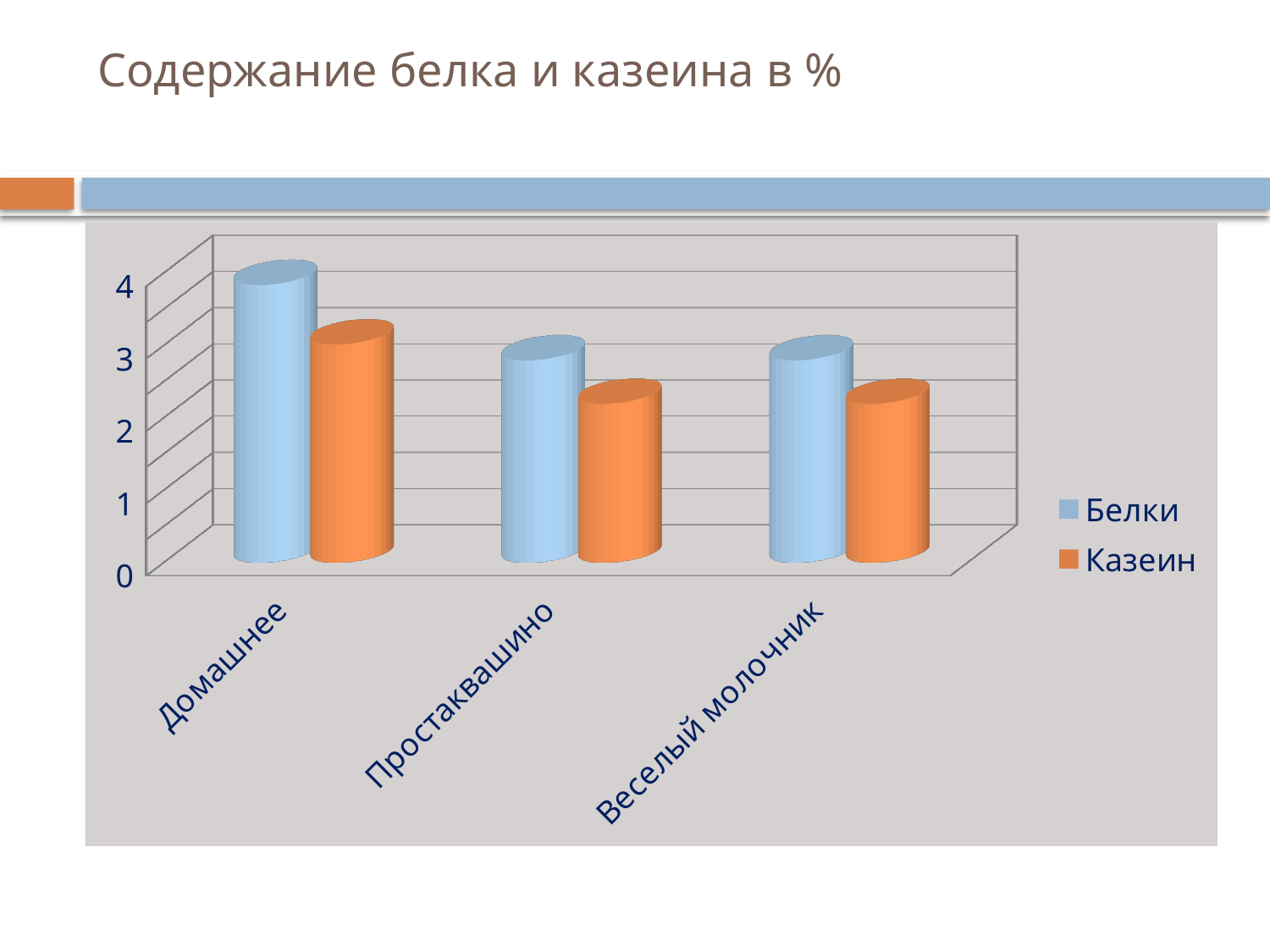
What is the title of the chart on the slide? Содержание белка и казеина в % Is the Казеин value for Простаквашино greater or less than 3? less For Домашнее, which is larger: Белки or Казеин? Белки Which is larger: the Белки value for Домашнее or the Белки value for Простаквашино? Домашнее How many series does the legend list? 2 Which category has the highest Казеин value? Домашнее Which category has the highest Белки value? Домашнее How many categories are shown on the x axis? 3 Is the Белки value for Домашнее greater or less than 3? greater What kind of chart is shown on the slide? bar chart Which series is shown in orange? Казеин